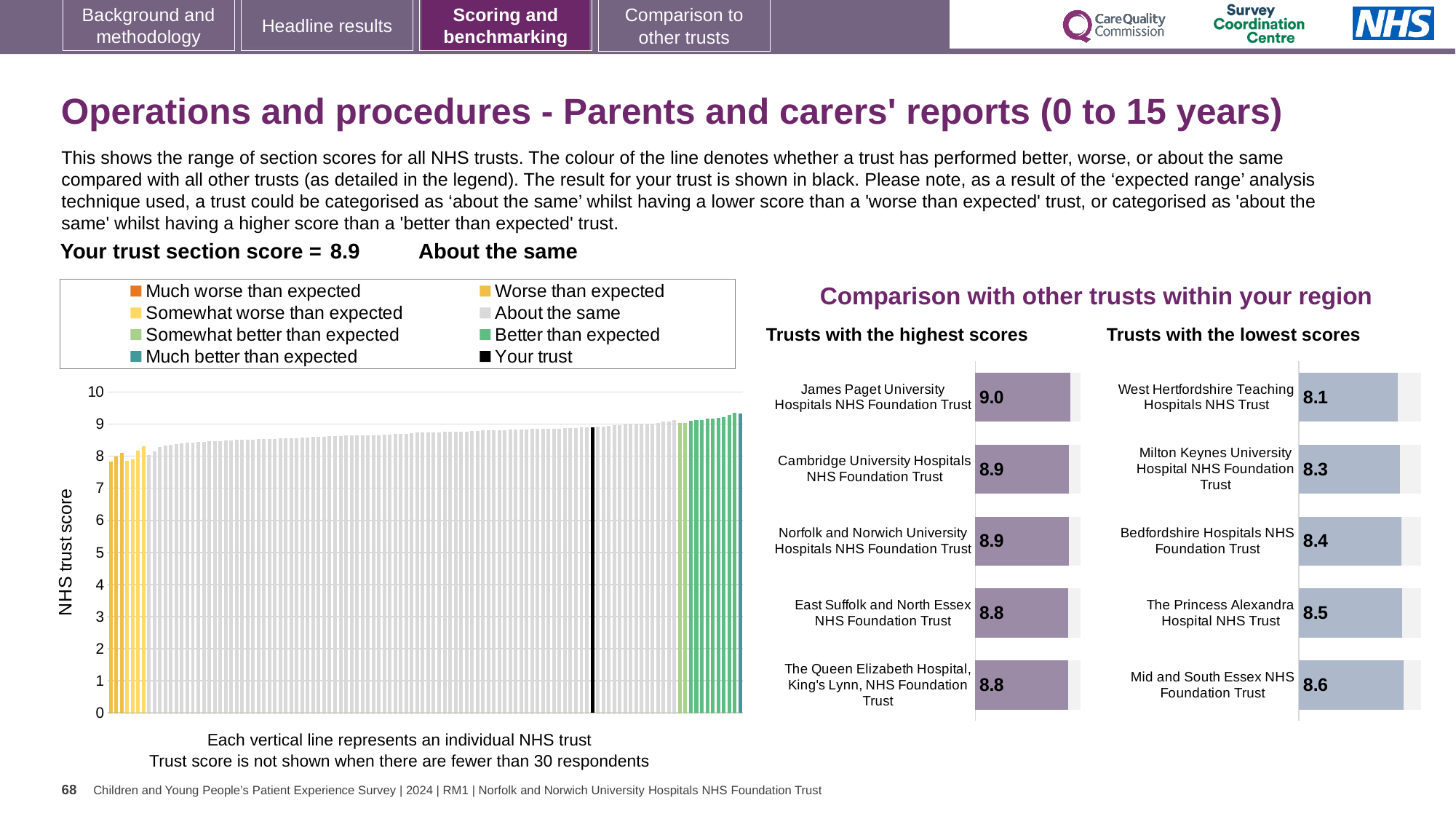
In the 'Trusts with the highest scores' chart, what is the score for James Paget University Hospitals NHS Foundation Trust? 9.0 How many trusts are listed in the 'Trusts with the highest scores' chart? 5 In the 'Trusts with the lowest scores' chart, which trust has the lowest score? West Hertfordshire Teaching Hospitals NHS Trust In the 'Trusts with the lowest scores' chart, which has the higher score: Milton Keynes University Hospital NHS Foundation Trust or The Princess Alexandra Hospital NHS Trust? The Princess Alexandra Hospital NHS Trust In the NHS trust score chart, is the value of the black 'Your trust' bar greater or less than 8? greater How many entries does the legend of the NHS trust score chart list? 8 In the 'Trusts with the highest scores' chart, which trust has the highest score? James Paget University Hospitals NHS Foundation Trust In the 'Trusts with the lowest scores' chart, what is the score for West Hertfordshire Teaching Hospitals NHS Trust? 8.1 In the NHS trust score chart, do the bar values rise or fall from left to right? Rise What kind of chart is the NHS trust score chart on the left? Bar chart In the 'Trusts with the lowest scores' chart, what is the score for Bedfordshire Hospitals NHS Foundation Trust? 8.4 In the 'Trusts with the lowest scores' chart, what is the difference between the scores of Mid and South Essex NHS Foundation Trust and West Hertfordshire Teaching Hospitals NHS Trust? 0.5